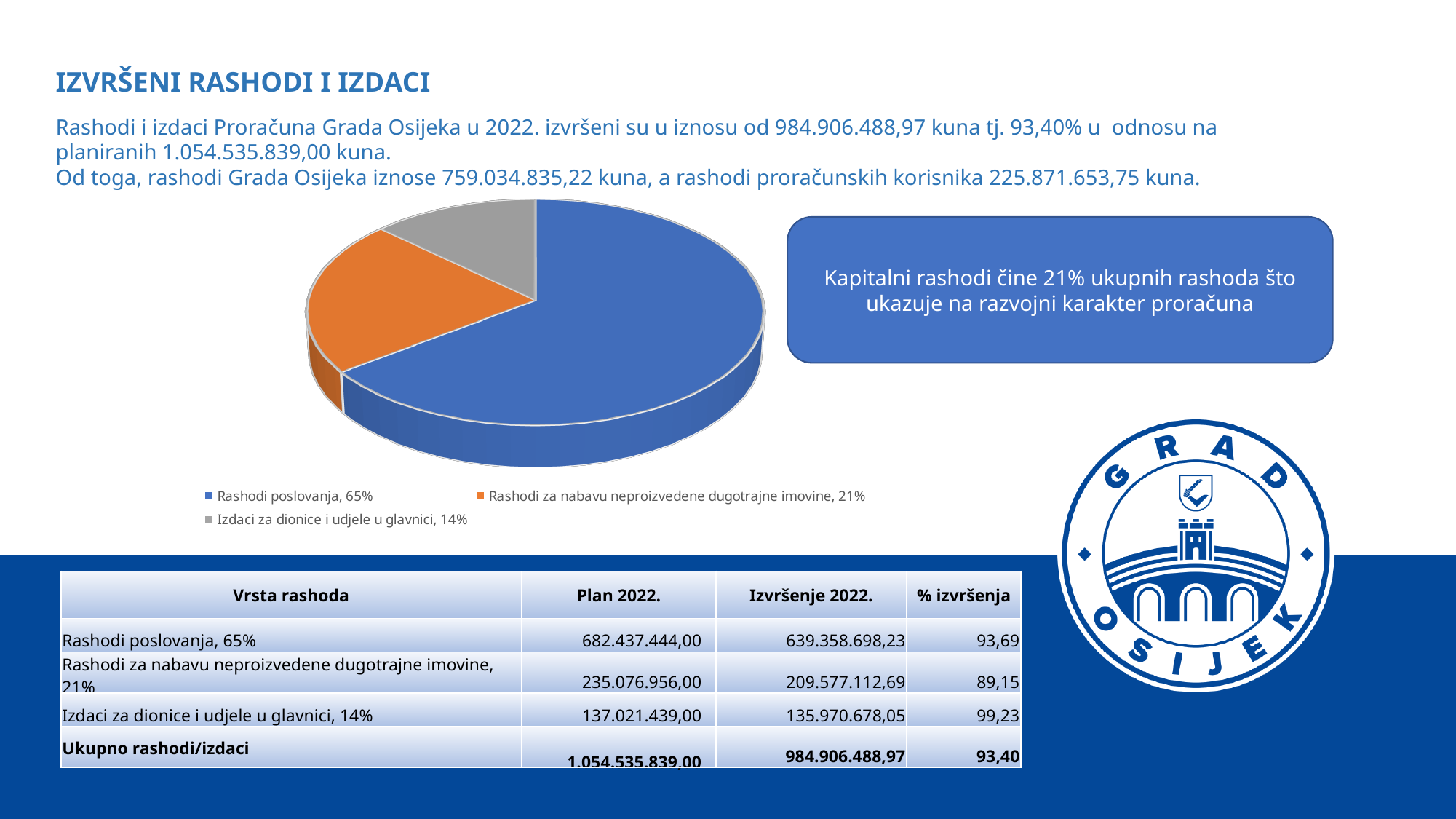
What kind of chart is shown on the slide? Pie chart How many slices does the pie chart have? 3 What share of the pie does "Rashodi poslovanja" represent? 65% What is the difference in percentage points between the "Rashodi za nabavu neproizvedene dugotrajne imovine" slice and the "Izdaci za dionice i udjele u glavnici" slice? 7 percentage points What share of the pie does "Izdaci za dionice i udjele u glavnici" represent? 14% Which category has the smallest slice of the pie chart? Izdaci za dionice i udjele u glavnici What colour is the "Izdaci za dionice i udjele u glavnici" slice in the pie chart? Grey Which category has the largest slice of the pie chart? Rashodi poslovanja What is the difference in percentage points between the "Rashodi poslovanja" slice and the "Rashodi za nabavu neproizvedene dugotrajne imovine" slice? 44 percentage points What colour is the "Rashodi poslovanja" slice in the pie chart? Blue What share of the pie does "Rashodi za nabavu neproizvedene dugotrajne imovine" represent? 21% Which slice is larger: "Rashodi za nabavu neproizvedene dugotrajne imovine" or "Izdaci za dionice i udjele u glavnici"? Rashodi za nabavu neproizvedene dugotrajne imovine